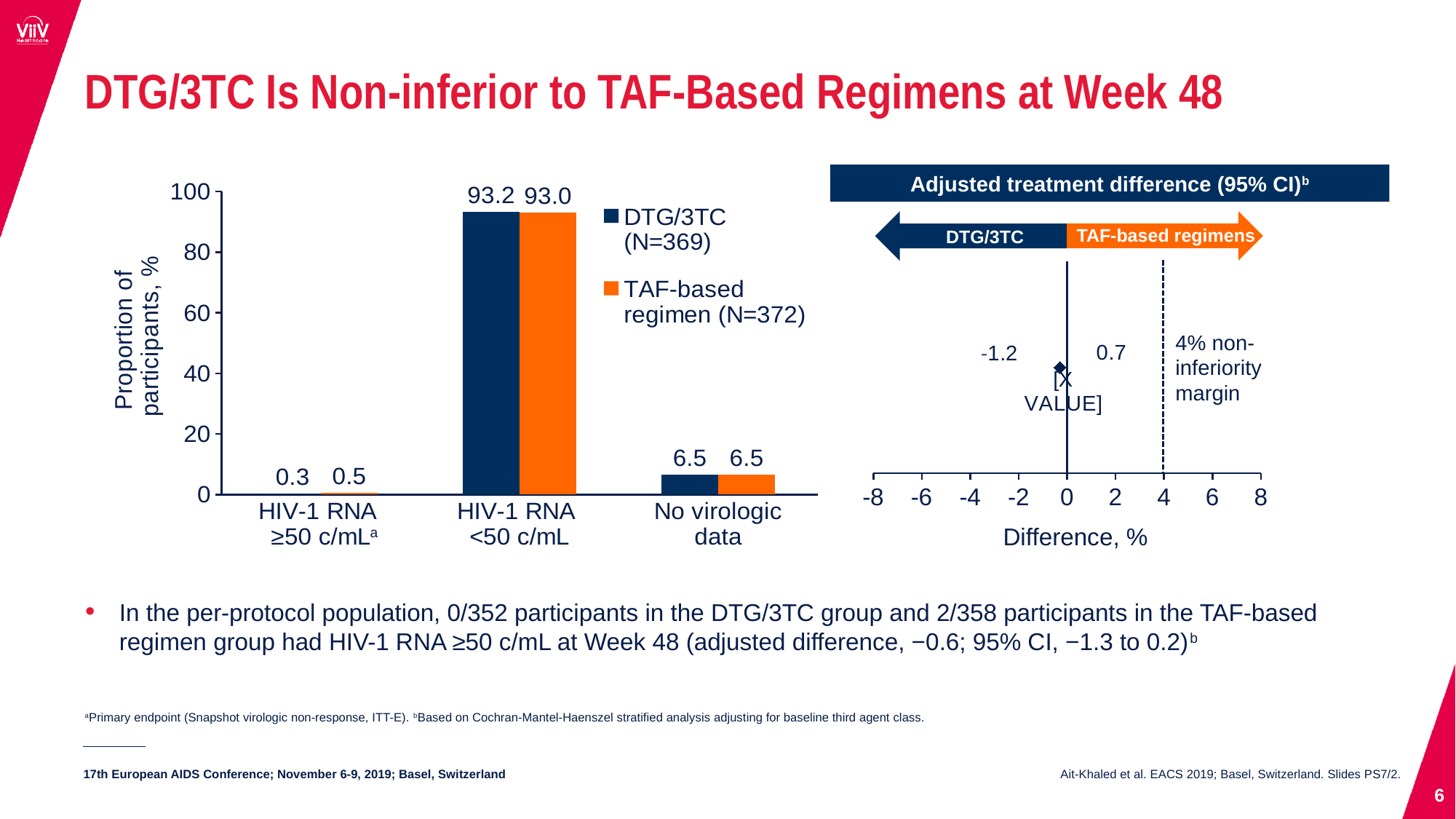
In the bar chart on the left, what is the value for the TAF-based regimen in the No virologic data category? 6.5 In the bar chart on the left, what is the difference between the DTG/3TC and TAF-based regimen values in the HIV-1 RNA <50 c/mL category? 0.2 In the bar chart on the left, which category has the lowest value for the TAF-based regimen? HIV-1 RNA ≥50 c/mL In the bar chart on the left, how many series does the legend list? 2 In the Adjusted treatment difference chart on the right, what are the lower and upper confidence interval values printed next to the point? -1.2 and 0.7 In the bar chart on the left, how many categories are shown on the x axis? 3 In the bar chart on the left, what is the value for the TAF-based regimen in the HIV-1 RNA ≥50 c/mL category? 0.5 In the bar chart on the left, which category has the highest value for DTG/3TC? HIV-1 RNA <50 c/mL In the bar chart on the left, what is the value for DTG/3TC in the HIV-1 RNA <50 c/mL category? 93.2 What kind of chart is the chart on the left of the slide? Bar chart In the bar chart on the left, what is the sample size (N) shown in the legend for the TAF-based regimen? N=372 In the bar chart on the left, is the DTG/3TC value for HIV-1 RNA <50 c/mL greater or less than 80? greater